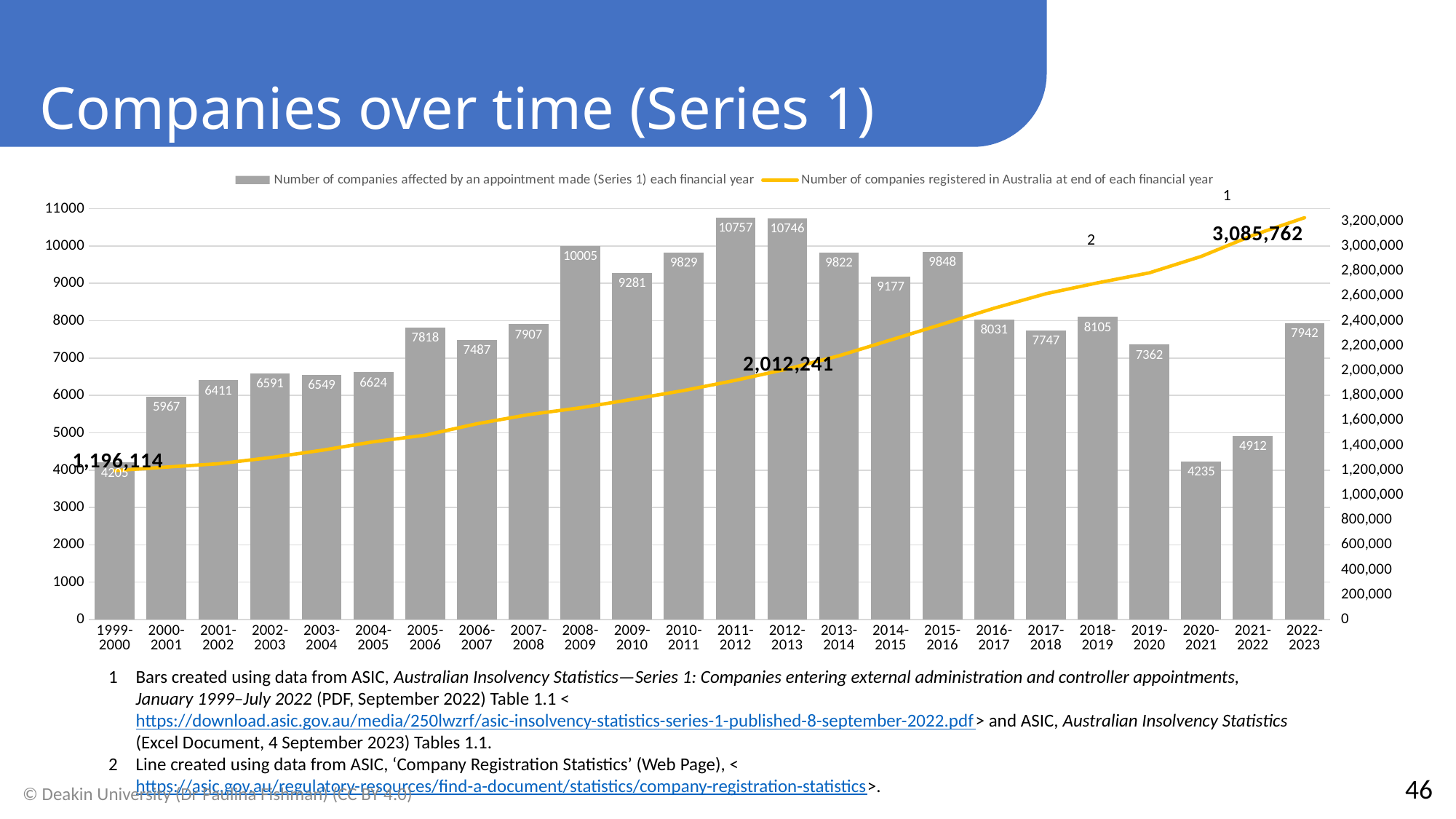
What colour is the line showing the number of companies registered in Australia? Yellow Which is larger: the number of companies affected by an appointment in 2015-2016 or in 2013-2014? 2015-2016 What is the number of companies affected by an appointment made in 2008-2009? 10005 Which financial year has the highest number of companies affected by an appointment made? 2011-2012 What is the number of companies affected by an appointment made in 2020-2021? 4235 What is the difference between the number of companies affected by an appointment in 2022-2023 and in 2021-2022? 3030 Does the number of companies registered in Australia rise or fall from 1999-2000 to 2022-2023? rise How many series does the legend list? 2 What is the difference between the number of companies affected by an appointment in 2011-2012 and in 2012-2013? 11 How many financial years are shown on the x axis? 24